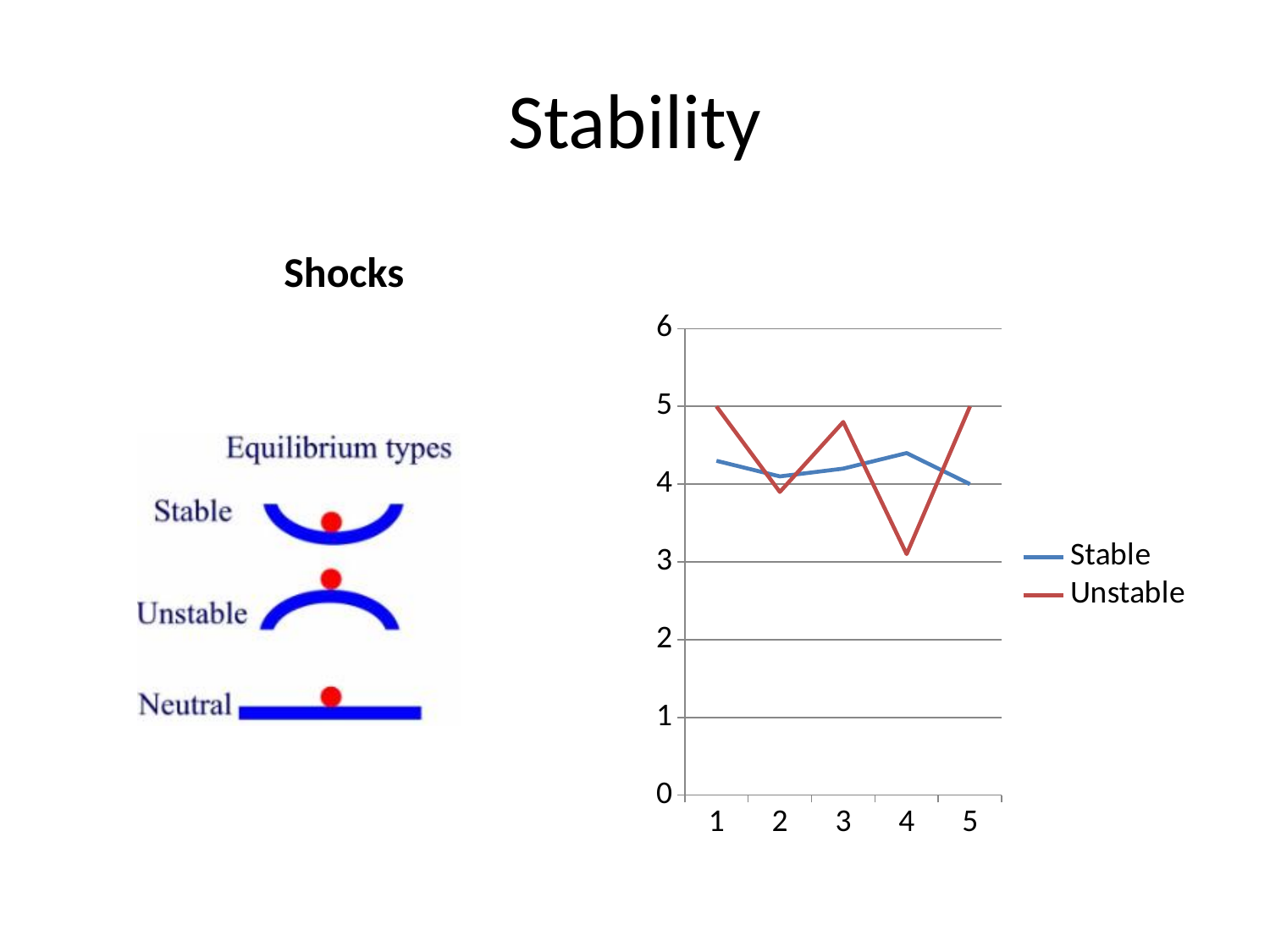
Is the value of the Stable series at x = 1 greater or less than 5? less What is the value of the Stable series at x = 5? 4 How many points are plotted along the x axis for each series? 5 At which x value does the Unstable series reach its lowest point? 4 Is the value of the Unstable series at x = 4 greater or less than 4? less At x = 3, which series has the larger value, Stable or Unstable? Unstable Which series is drawn in red? Unstable What kind of chart is shown on the slide? line chart How many series does the chart's legend list? 2 At x = 4, which series has the larger value, Stable or Unstable? Stable What is the value of the Unstable series at x = 1? 5 Is the value of the Unstable series at x = 3 greater or less than 4? greater